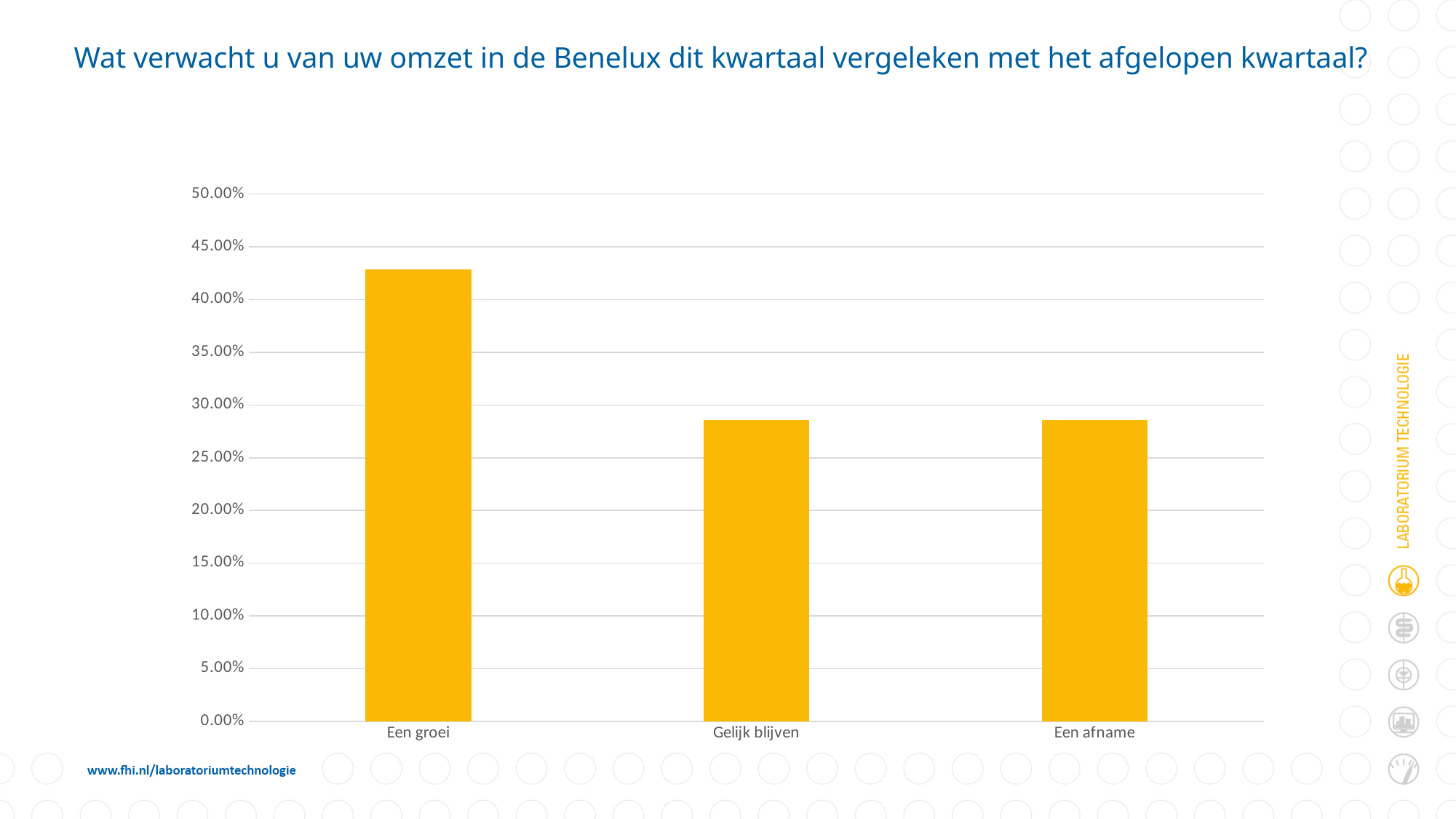
Is the value for Een afname greater or less than 30.00%? less Is the value for Een groei greater or less than 45.00%? less Which category has the highest value in the chart? Een groei What is the title of the chart? Wat verwacht u van uw omzet in de Benelux dit kwartaal vergeleken met het afgelopen kwartaal? What colour are the bars in the chart? yellow Is the value for Gelijk blijven greater or less than 25.00%? greater Which is larger, the value for Een groei or the value for Gelijk blijven? Een groei What kind of chart is shown on the slide? bar chart How many categories are shown on the x axis of the chart? 3